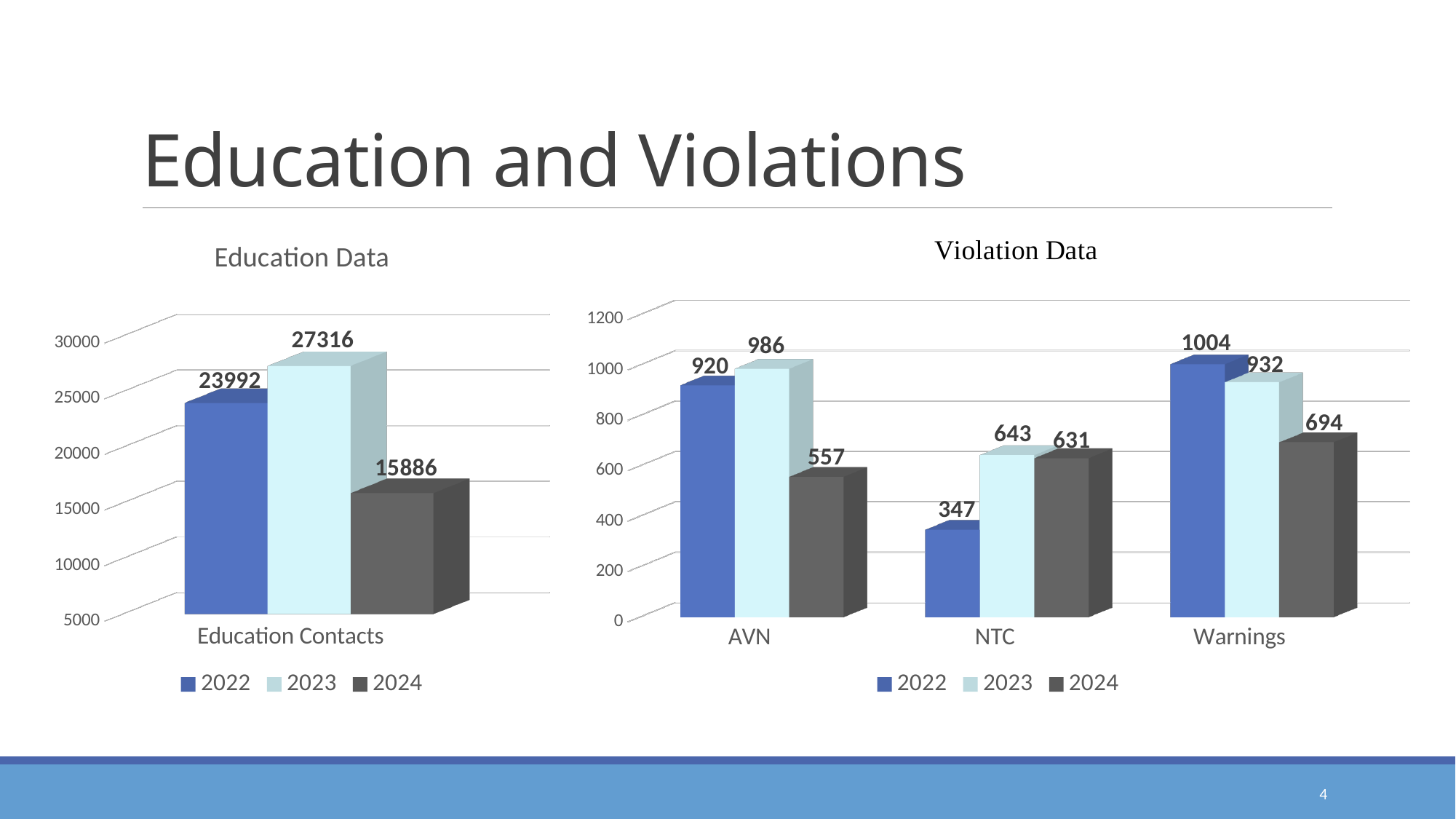
In the Education Data chart, what is the difference between the 2023 and 2022 values for Education Contacts? 3324 In the Education Data chart, which year has the lowest value for Education Contacts? 2024 In the Violation Data chart, which category has the lowest 2023 value? NTC In the Violation Data chart, what is the value for NTC in 2022? 347 In the Violation Data chart, what is the value for Warnings in 2024? 694 In the Violation Data chart, what is the difference between the 2022 and 2024 values for AVN? 363 How many categories are shown on the x axis of the Violation Data chart? 3 How many series does the legend of the Education Data chart list? 3 In the Violation Data chart, is the 2023 value for NTC larger or the 2024 value for NTC? 2023 In the Violation Data chart, which category has the highest 2022 value? Warnings In the Education Data chart, what is the value for Education Contacts in 2023? 27316 What kind of chart is the Violation Data chart? Bar chart